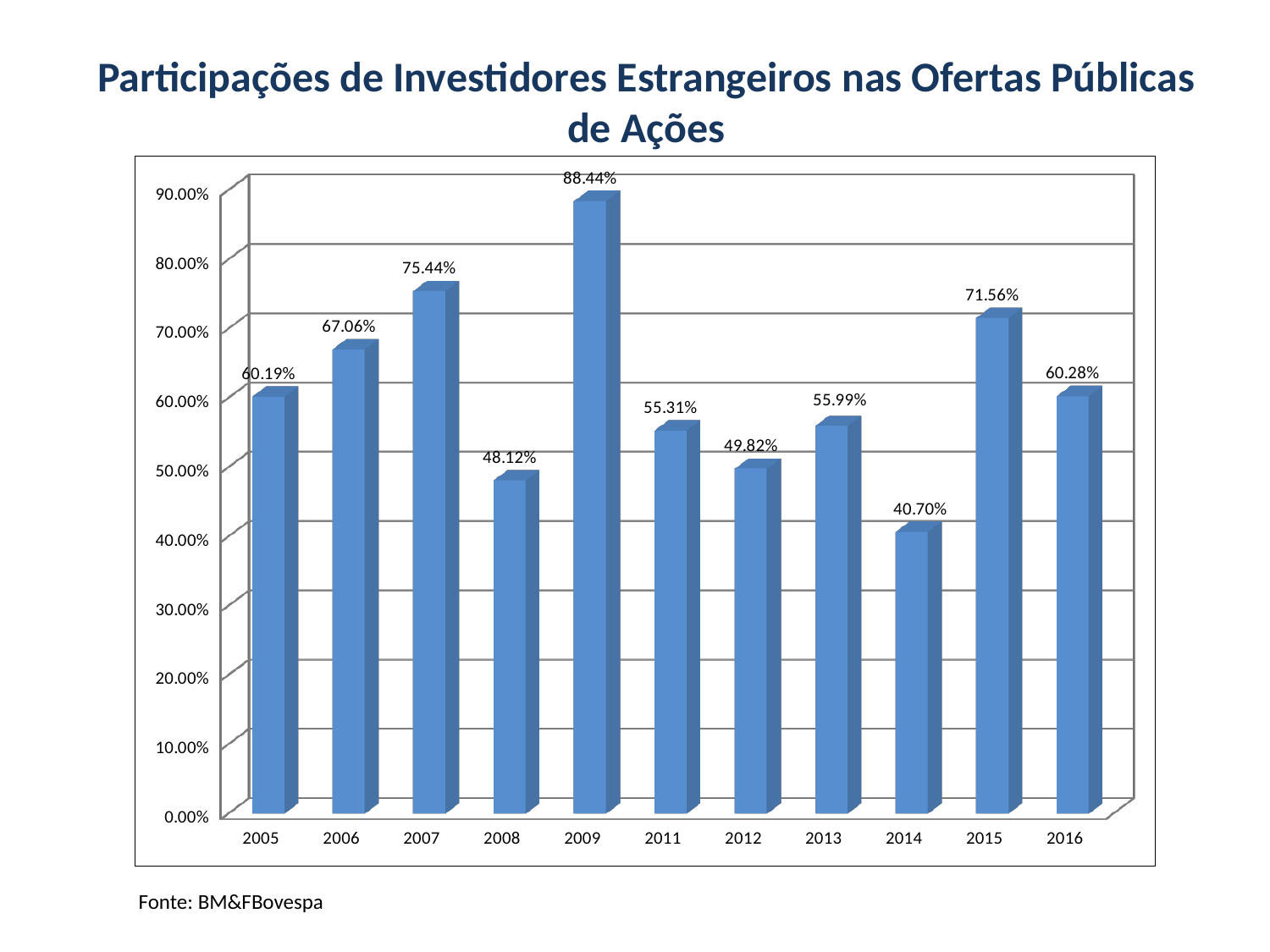
What is the difference between the values for 2009 and 2014? 47.74% What kind of chart is shown on the slide? bar chart Which year has the highest value? 2009 Is the value for 2008 greater or less than 50.00%? less What is the difference between the values for 2007 and 2006? 8.38% What is the value for 2014? 40.70% Which year has the lowest value? 2014 What is the value for 2016? 60.28% Do the values rise or fall from 2005 to 2007? rise What is the value for 2009? 88.44% Which is larger, the value for 2007 or the value for 2015? 2007 How many years are shown on the x axis? 11